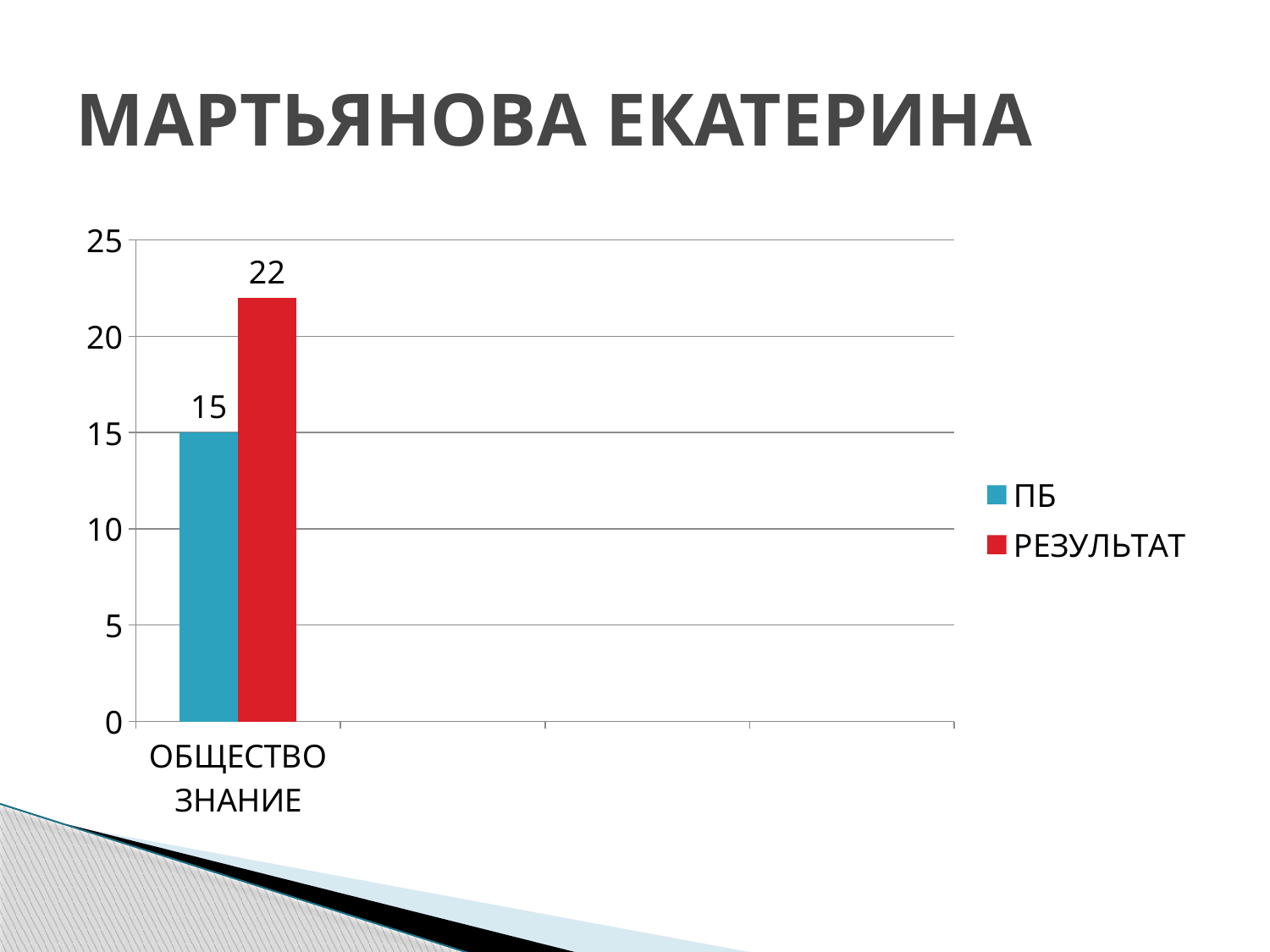
How many series does the legend list? 2 What kind of chart is shown on the slide? bar chart Is the value of ПБ for ОБЩЕСТВОЗНАНИЕ greater or less than 20? less What is the value of РЕЗУЛЬТАТ for ОБЩЕСТВОЗНАНИЕ? 22 What is the value of ПБ for ОБЩЕСТВОЗНАНИЕ? 15 How many categories are shown on the x axis? 1 Which series has the higher value for ОБЩЕСТВОЗНАНИЕ, ПБ or РЕЗУЛЬТАТ? РЕЗУЛЬТАТ What is the difference between РЕЗУЛЬТАТ and ПБ for ОБЩЕСТВОЗНАНИЕ? 7 Is the value of РЕЗУЛЬТАТ for ОБЩЕСТВОЗНАНИЕ greater or less than 20? greater What colour is the bar for the РЕЗУЛЬТАТ series? red What is the title of the slide? МАРТЬЯНОВА ЕКАТЕРИНА What is the maximum value shown on the y axis? 25